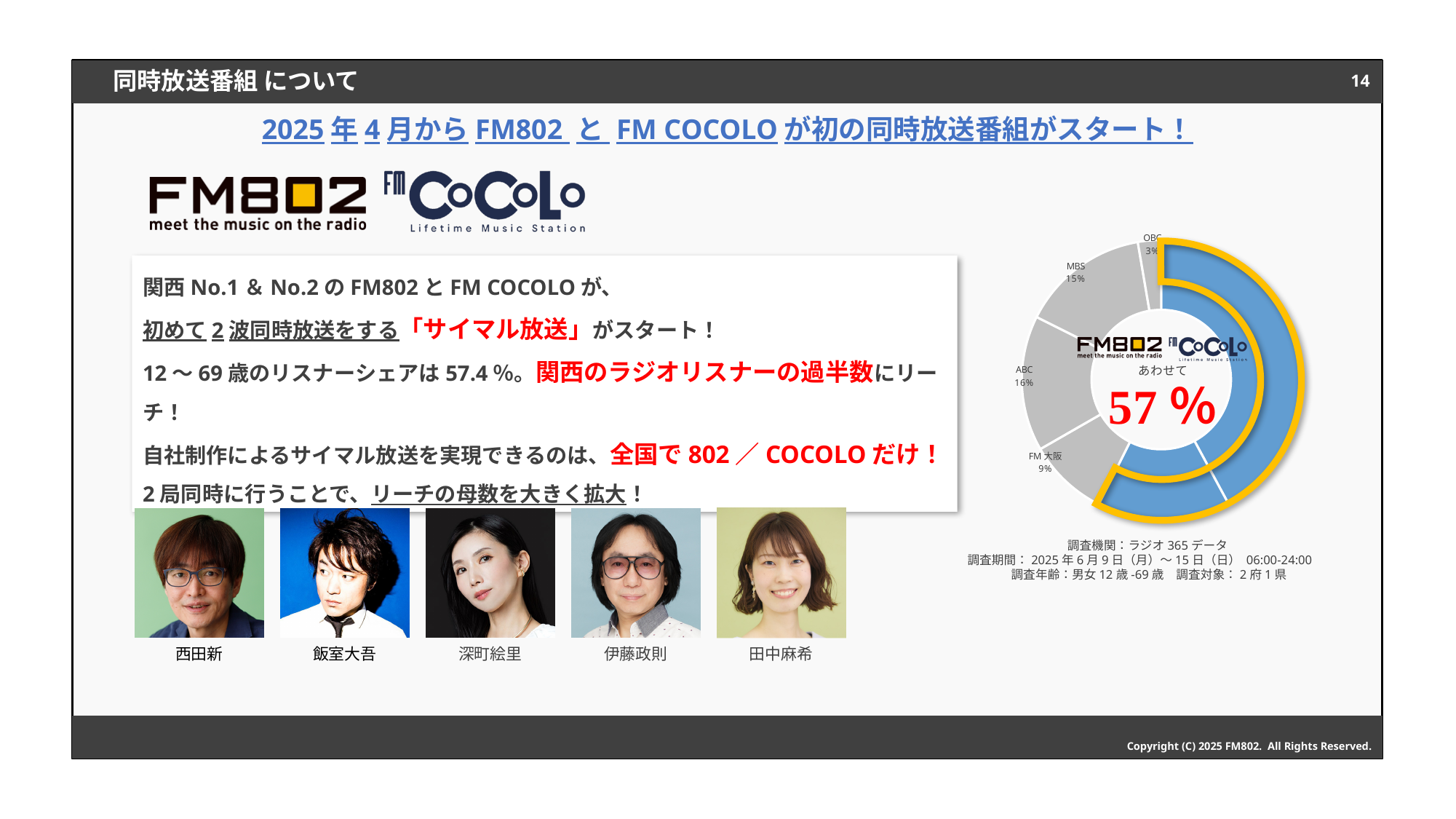
What kind of chart is shown on the right side of the slide? Pie chart (donut) In the donut chart, what share is shown for ABC? 16% Among the stations labelled with percentages in the grey part of the donut chart (OBC, MBS, ABC, FM大阪), which has the lowest share? OBC In the donut chart, what colour are the segments representing FM802 and FM COCOLO? Blue According to the centre of the donut chart, what is the combined share (あわせて) of FM802 and FM COCOLO? 57% In the donut chart, what is the difference between the shares of MBS and OBC? 12% In the donut chart, which has the larger share, ABC or MBS? ABC In the donut chart, what share is shown for FM大阪? 9% Among the stations labelled with percentages in the grey part of the donut chart (OBC, MBS, ABC, FM大阪), which has the highest share? ABC In the donut chart, what share is shown for OBC? 3% In the donut chart, what share is shown for MBS? 15% In the donut chart, what is the difference between the shares of ABC and FM大阪? 7%